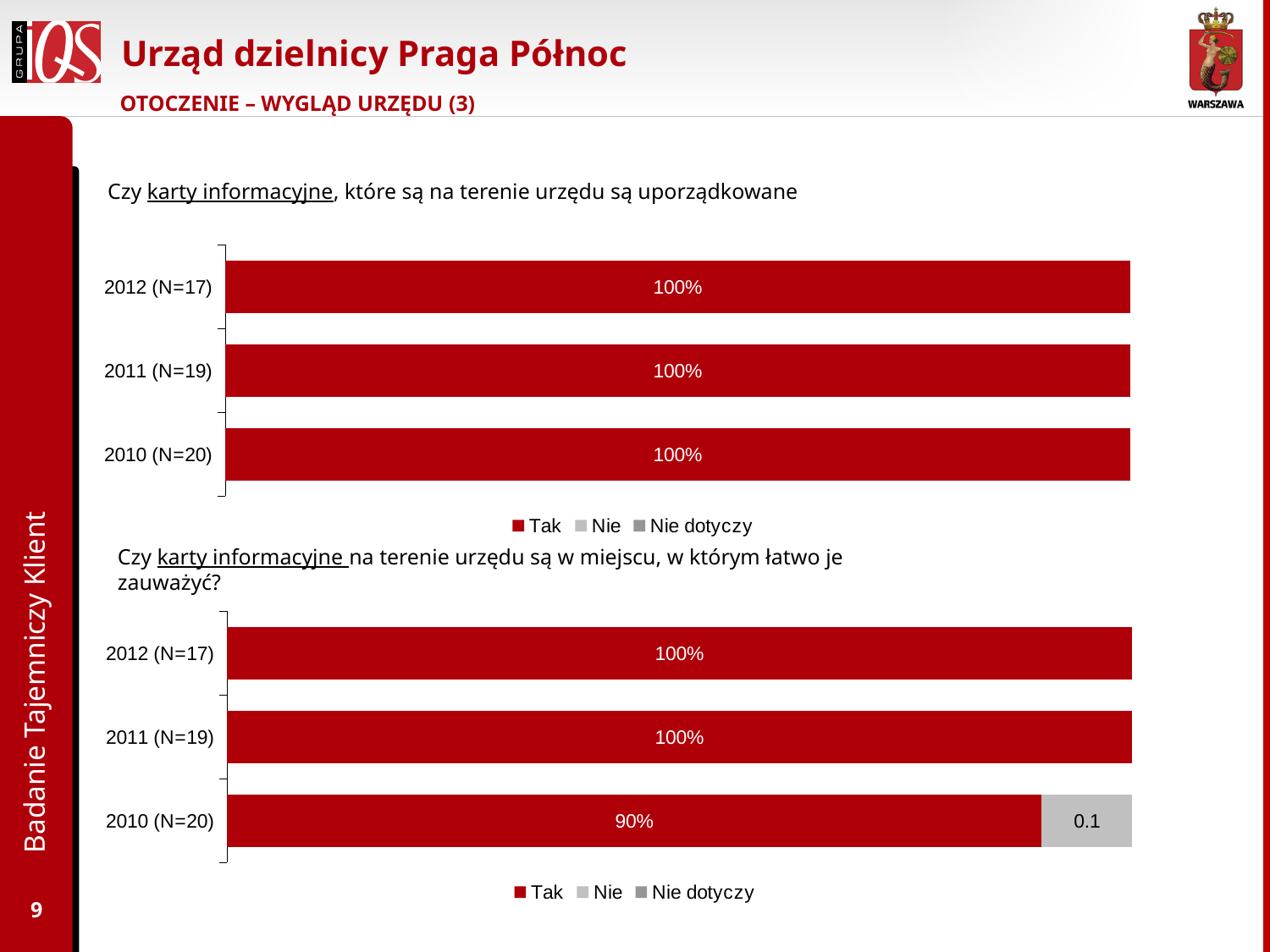
In the top chart (karty informacyjne uporządkowane), what is the value of 'Tak' for 2010 (N=20)? 100% In the bottom chart (karty informacyjne łatwo zauważyć), what is the difference between the 'Tak' value for 2012 (N=17) and for 2010 (N=20)? 10% What are the legend entries of the top chart (karty informacyjne uporządkowane)? Tak, Nie, Nie dotyczy In the bottom chart (karty informacyjne łatwo zauważyć), which year has the lowest 'Tak' value? 2010 (N=20) In the bottom chart (karty informacyjne łatwo zauważyć), what is the value of 'Tak' for 2010 (N=20)? 90% In the top chart (karty informacyjne uporządkowane), what is the value of 'Tak' for 2012 (N=17)? 100% In the bottom chart (karty informacyjne łatwo zauważyć), what is the value of 'Tak' for 2011 (N=19)? 100% How many series does the legend of the bottom chart (karty informacyjne łatwo zauważyć) list? 3 In the bottom chart (karty informacyjne łatwo zauważyć), what label is printed on the grey segment for 2010 (N=20)? 0.1 In the bottom chart (karty informacyjne łatwo zauważyć), is the 'Tak' value for 2012 (N=17) larger or smaller than for 2010 (N=20)? larger What type of chart is the top chart (karty informacyjne uporządkowane)? bar chart How many year categories are shown in the top chart (karty informacyjne uporządkowane)? 3